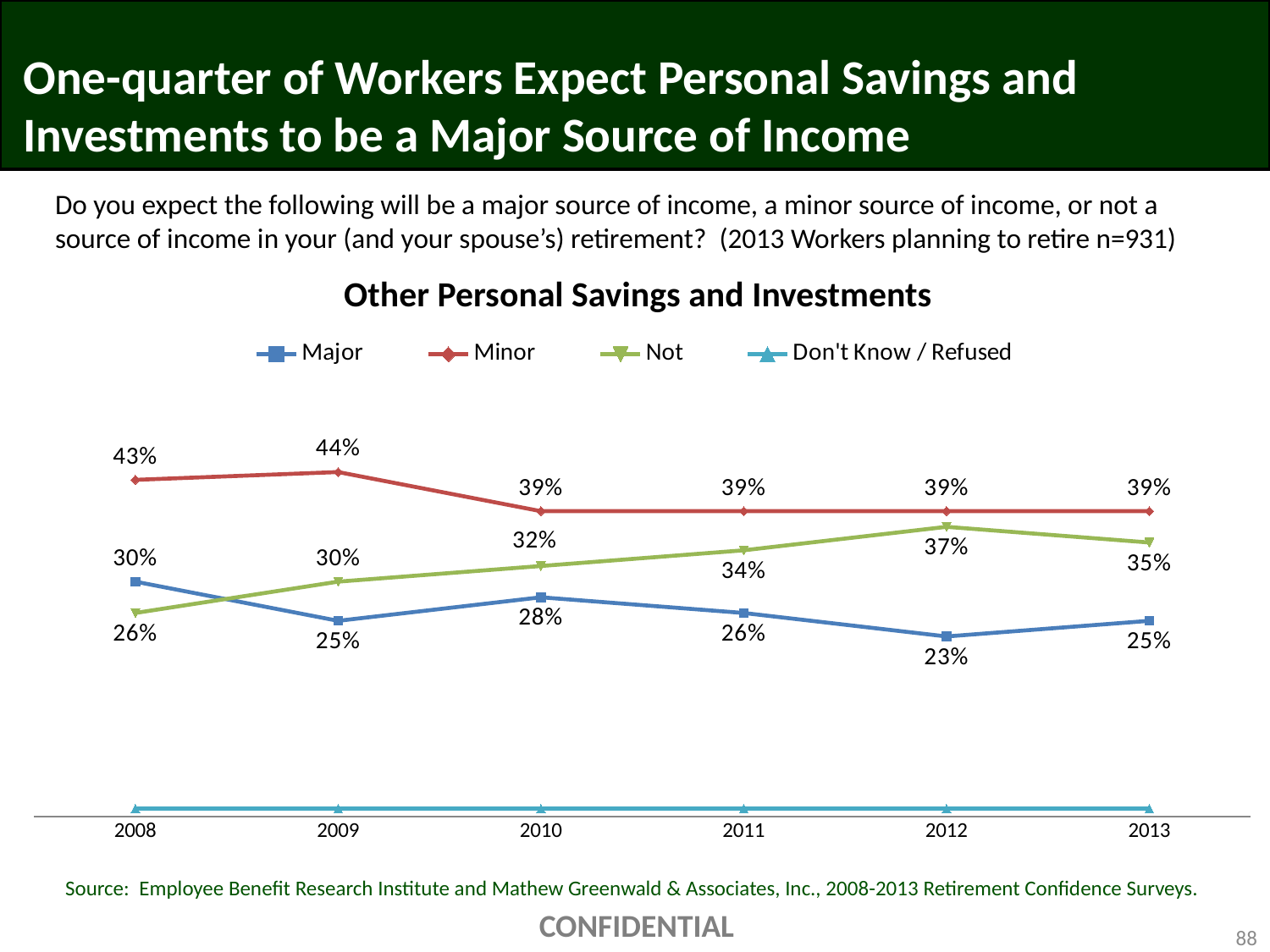
What is the value for Not in 2011? 34% What is the title of the chart? Other Personal Savings and Investments Which is larger in 2008, the Major value or the Not value? Major In which year is the Minor series at its highest? 2009 How many years are shown on the x axis? 6 Does the Not series generally rise or fall from 2008 to 2012? rise What type of chart is shown on the slide? line chart What is the value for Minor in 2009? 44% What is the difference between the Not value and the Major value in 2013? 10% In which year is the Major series at its lowest? 2012 What is the value for Major in 2012? 23% How many series does the legend list? 4